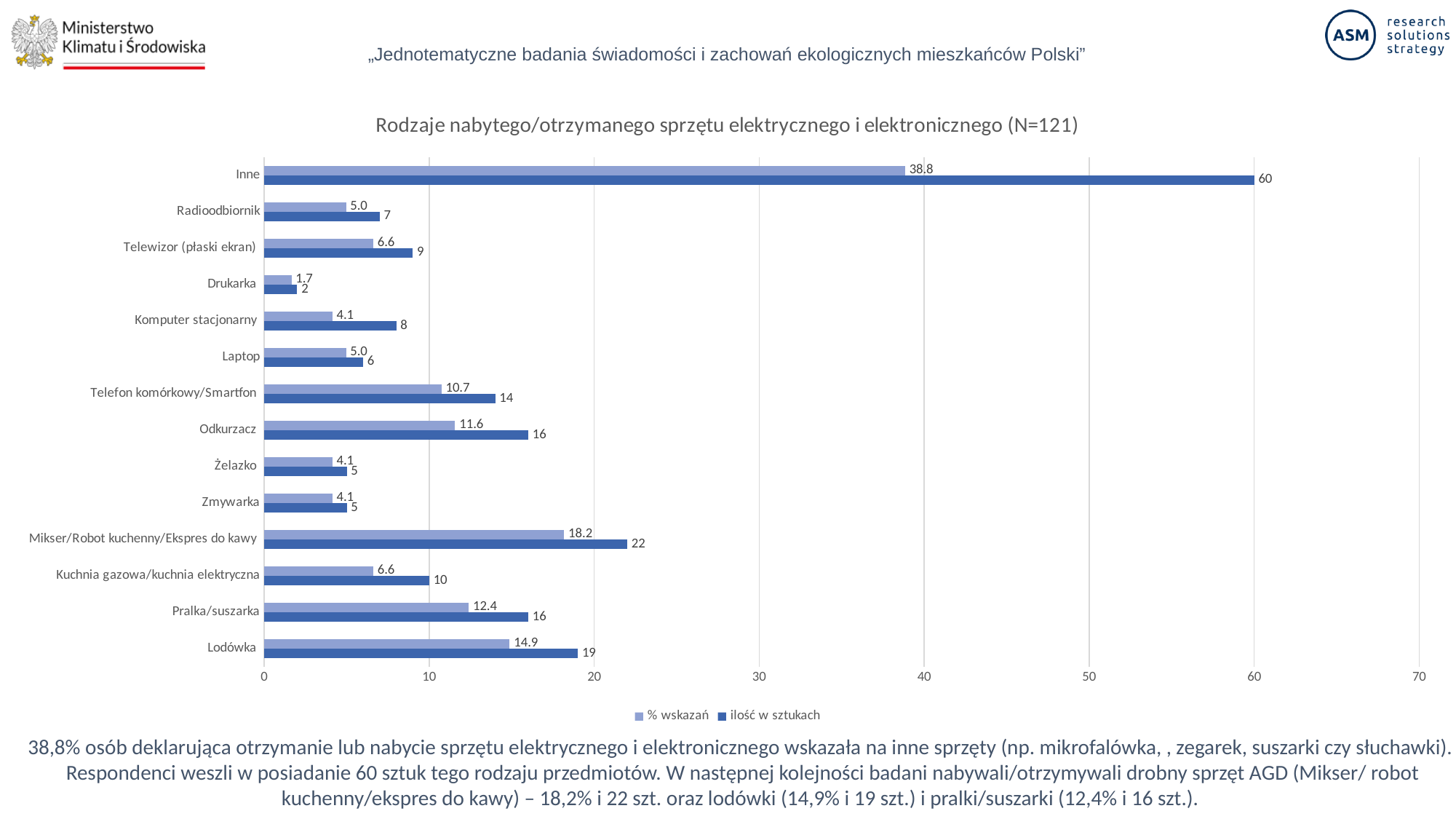
Which category has the highest '% wskazań' value? Inne Is the 'ilość w sztukach' value for Inne greater or less than 50? greater What is the 'ilość w sztukach' value for Inne? 60 How many series does the legend list? 2 What is the title of the chart? Rodzaje nabytego/otrzymanego sprzętu elektrycznego i elektronicznego (N=121) What is the difference in 'ilość w sztukach' between Mikser/Robot kuchenny/Ekspres do kawy and Lodówka? 3 What kind of chart is shown on the slide? bar chart How many categories are shown on the chart? 14 Which category has the lowest 'ilość w sztukach' value? Drukarka Which has a larger 'ilość w sztukach' value, Odkurzacz or Telefon komórkowy/Smartfon? Odkurzacz What is the '% wskazań' value for Mikser/Robot kuchenny/Ekspres do kawy? 18.2 What is the 'ilość w sztukach' value for Lodówka? 19